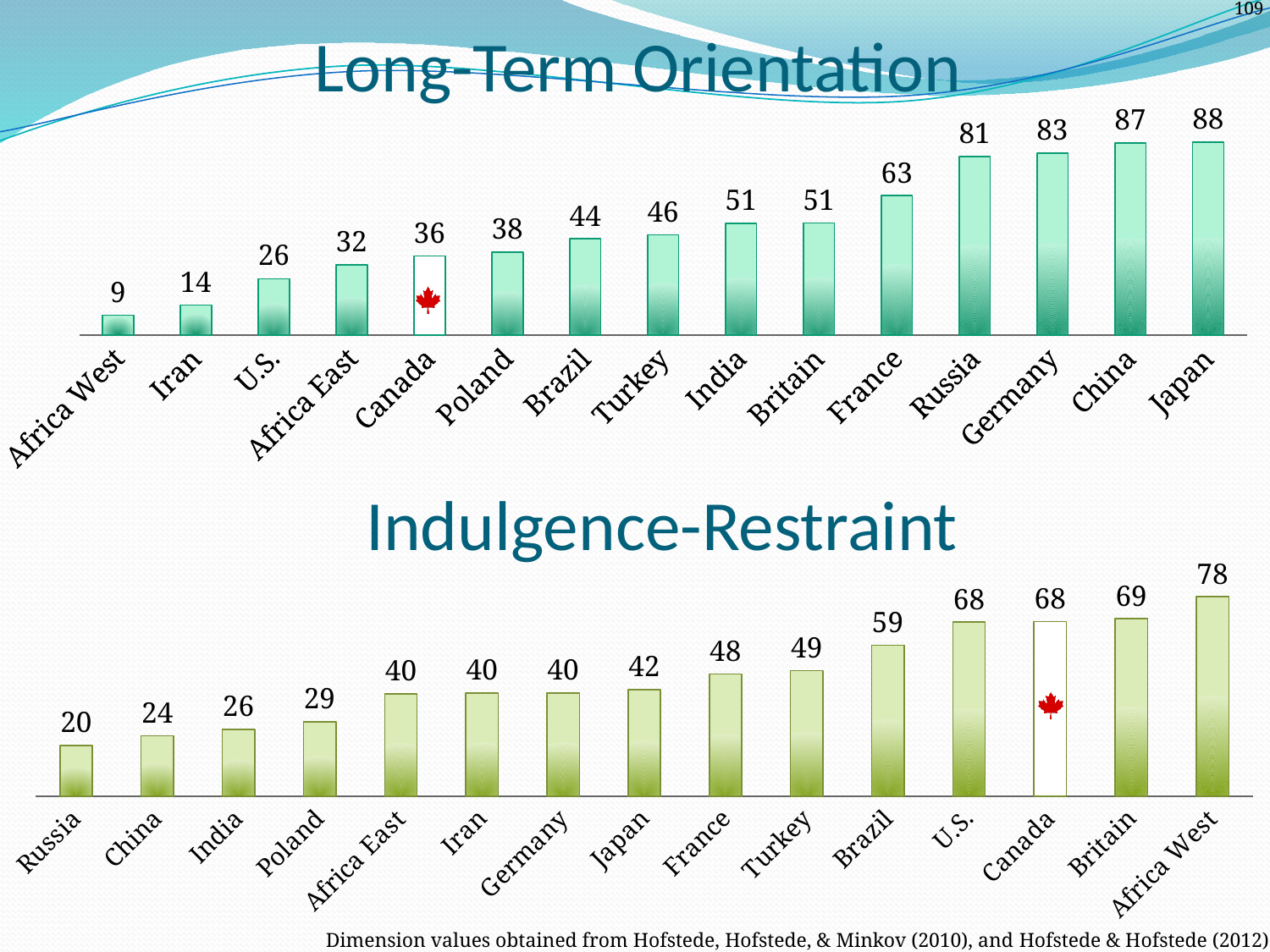
In the Indulgence-Restraint chart, what is the difference between the values for Canada and Poland? 39 In the Long-Term Orientation chart, what is the difference between the values for Japan and Africa West? 79 What kind of chart is the Indulgence-Restraint chart? bar chart In the Indulgence-Restraint chart, which is larger, the value for Turkey or the value for France? Turkey In the Long-Term Orientation chart, do the values rise or fall from left to right? rise In the Indulgence-Restraint chart, which country has the lowest value? Russia In the Indulgence-Restraint chart, what is the value for Brazil? 59 In the Indulgence-Restraint chart, which category has the highest value? Africa West In the Long-Term Orientation chart, which country has the highest value? Japan In the Long-Term Orientation chart, which category has the lowest value? Africa West In the Long-Term Orientation chart, what is the value for Canada? 36 In the Long-Term Orientation chart, how many categories are plotted? 15